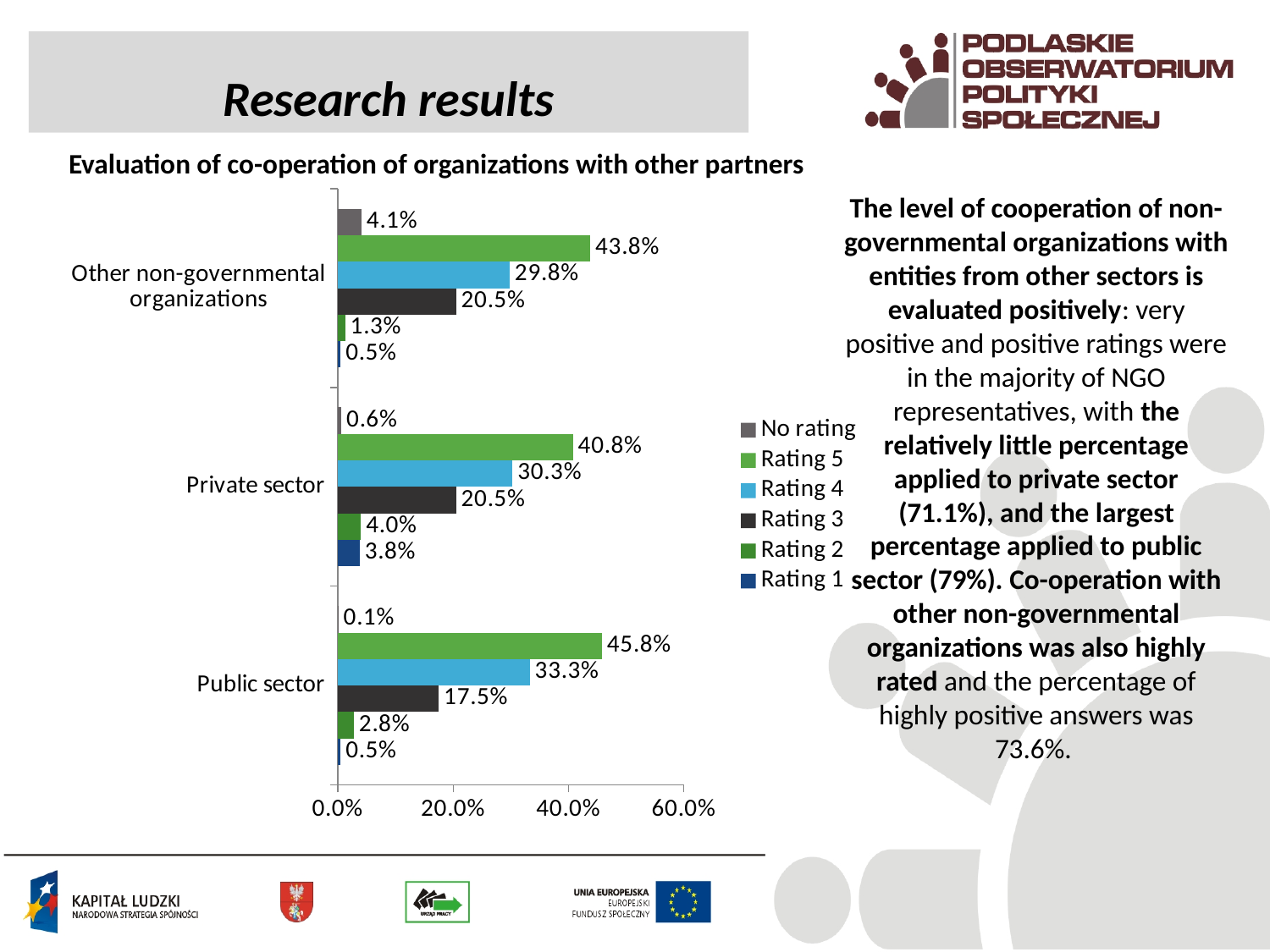
What is the difference between the Rating 5 values for Public sector and Private sector? 5.0% What is the No rating value for Other non-governmental organizations? 4.1% Is the Rating 4 value for Other non-governmental organizations greater or less than 20.0%? greater What is the title of the chart? Evaluation of co-operation of organizations with other partners What kind of chart is shown on the slide? Bar chart How many series does the legend list? 6 How many partner categories are shown on the chart? 3 Which category has the lowest Rating 3 value? Public sector What is the Rating 5 value for Public sector? 45.8% Which is larger: the Rating 1 value for Private sector or for Public sector? Private sector Which category has the highest Rating 5 value? Public sector What is the Rating 4 value for Private sector? 30.3%